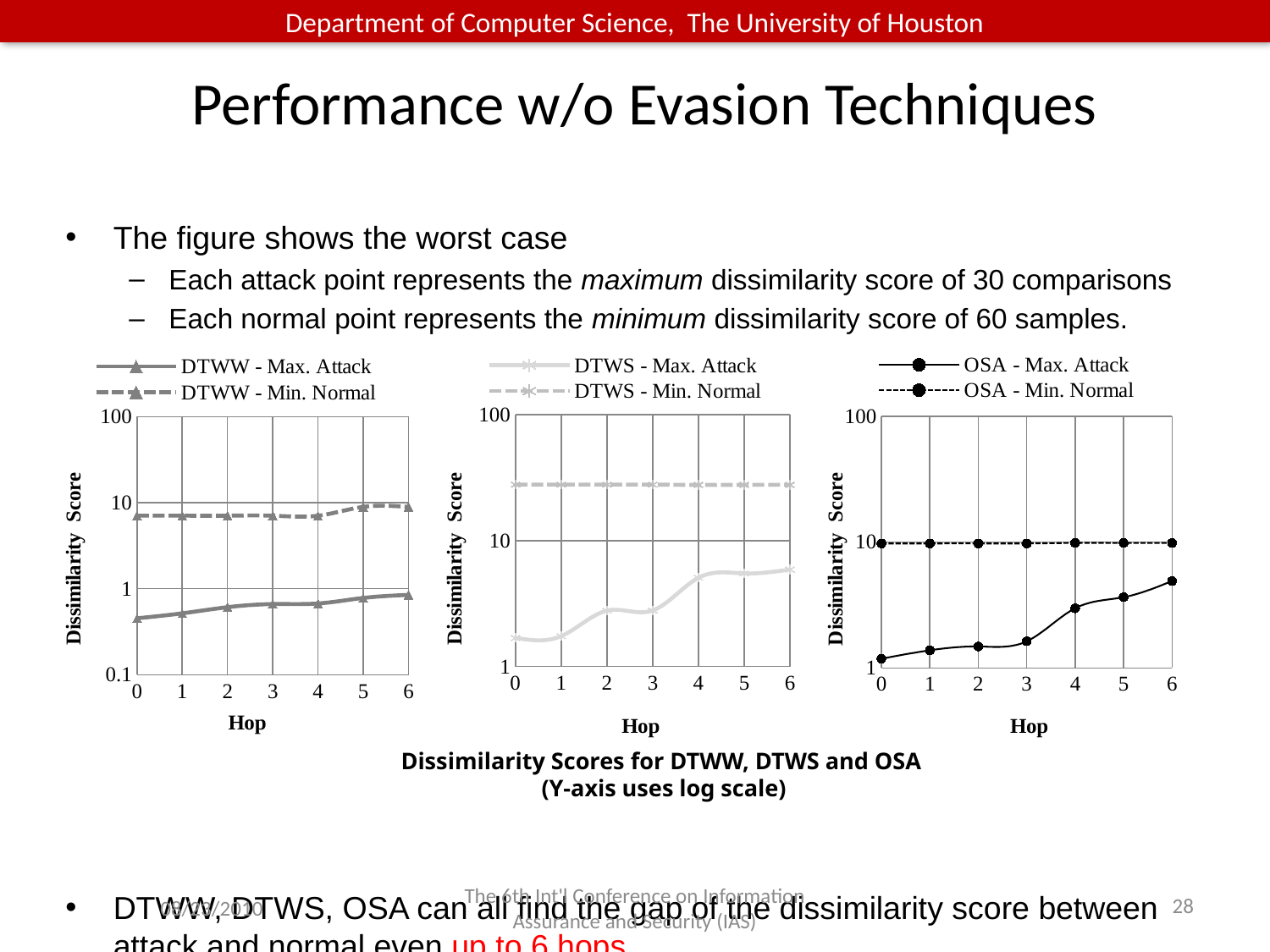
How many series does the legend of the left chart (DTWW) list? 2 What is the caption printed below the three charts? Dissimilarity Scores for DTWW, DTWS and OSA (Y-axis uses log scale) In the middle chart (DTWS), is the value of DTWS - Min. Normal at hop 3 greater or less than 10? greater What kind of chart is the left chart (DTWW)? line chart In the left chart (DTWW), is the value of DTWW - Max. Attack at hop 0 greater or less than 1? less What are the two legend entries of the left chart (DTWW)? DTWW - Max. Attack and DTWW - Min. Normal In the left chart (DTWW), does the DTWW - Max. Attack series rise or fall from hop 0 to hop 6? rise In the middle chart (DTWS), is the value of DTWS - Max. Attack at hop 0 greater or less than 10? less In the middle chart (DTWS), does the DTWS - Max. Attack series rise or fall from hop 0 to hop 6? rise How many hop points are plotted for each series in the right chart (OSA)? 7 In the right chart (OSA), which is larger at hop 6: OSA - Max. Attack or OSA - Min. Normal? OSA - Min. Normal